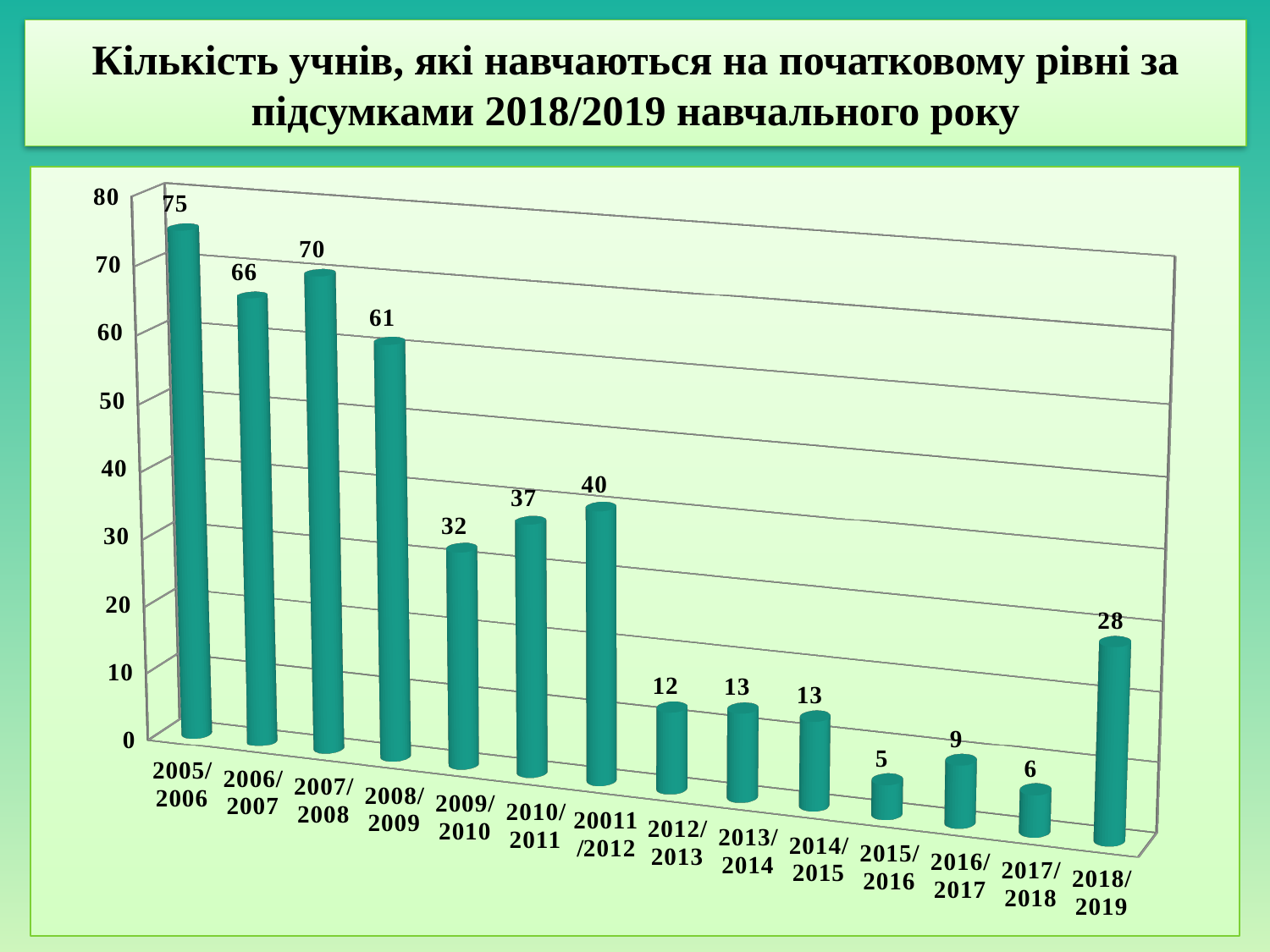
What is the value for 2016/2017? 9 What is the value for 2009/2010? 32 What kind of chart is shown on the slide? bar chart What is the difference between the values for 2007/2008 and 2008/2009? 9 How many school years (bars) are shown on the chart? 14 Which is larger, the value for 2010/2011 or the value for 2009/2010? 2010/2011 Which school year has the highest value? 2005/2006 What is the value for 2005/2006? 75 Which school year has the lowest value? 2015/2016 What is the value for 2018/2019? 28 Do the values generally rise or fall from 2005/2006 to 2017/2018? fall What is the difference between the values for 2005/2006 and 2018/2019? 47